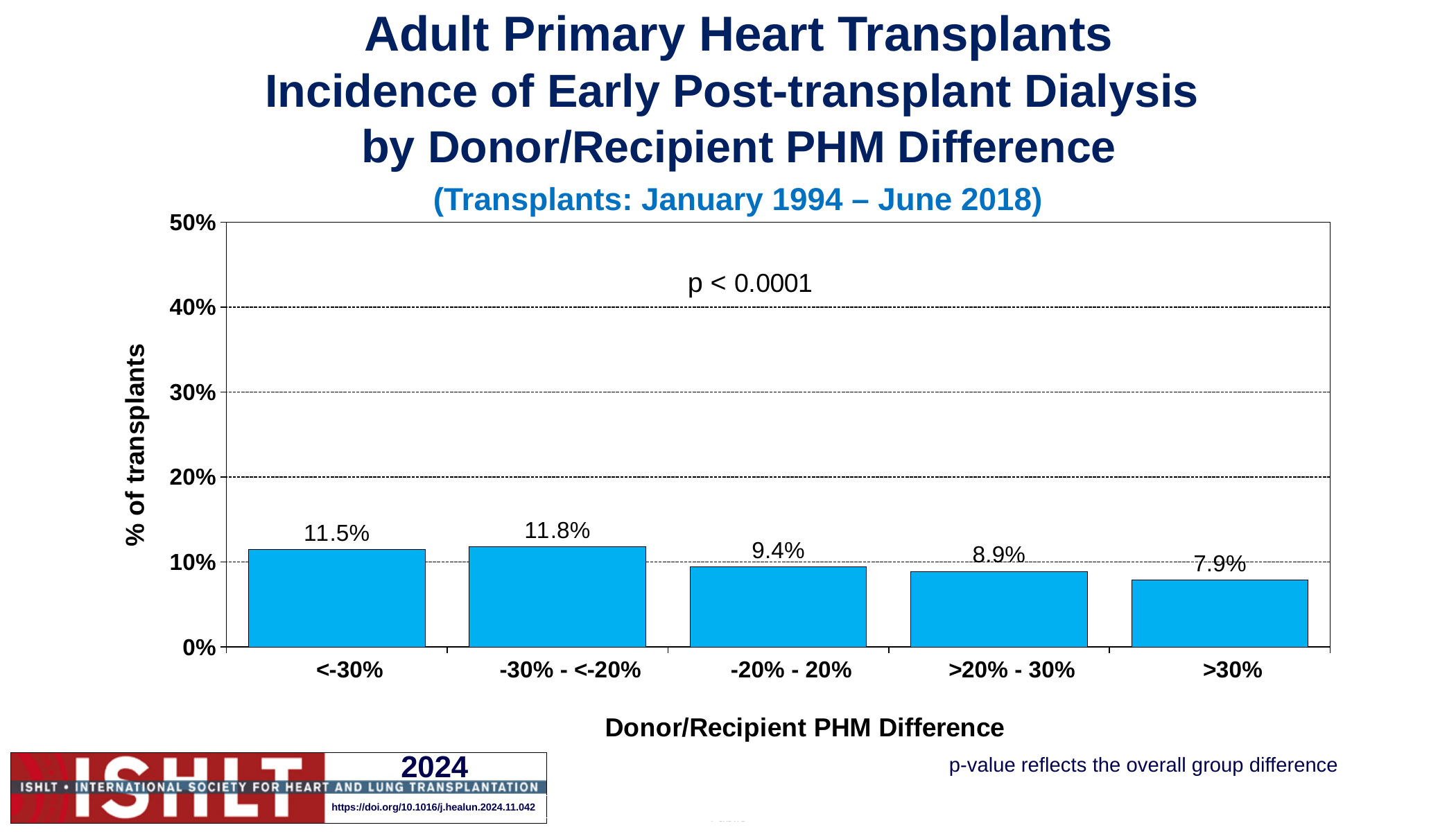
What kind of chart is shown? bar chart How many categories are shown on the x axis? 5 What is the value for the <-30% category? 11.5% What p-value is printed on the chart? p < 0.0001 Is the value for >20% - 30% greater or less than 10%? less Which category has the highest value? -30% - <-20% Which category has the lowest value? >30% What is the value for the -30% - <-20% category? 11.8% What is the value for the -20% - 20% category? 9.4% What is the value for the >30% category? 7.9% What is the difference between the values for -30% - <-20% and >30%? 3.9% Which is larger, the value for -20% - 20% or the value for >20% - 30%? -20% - 20%